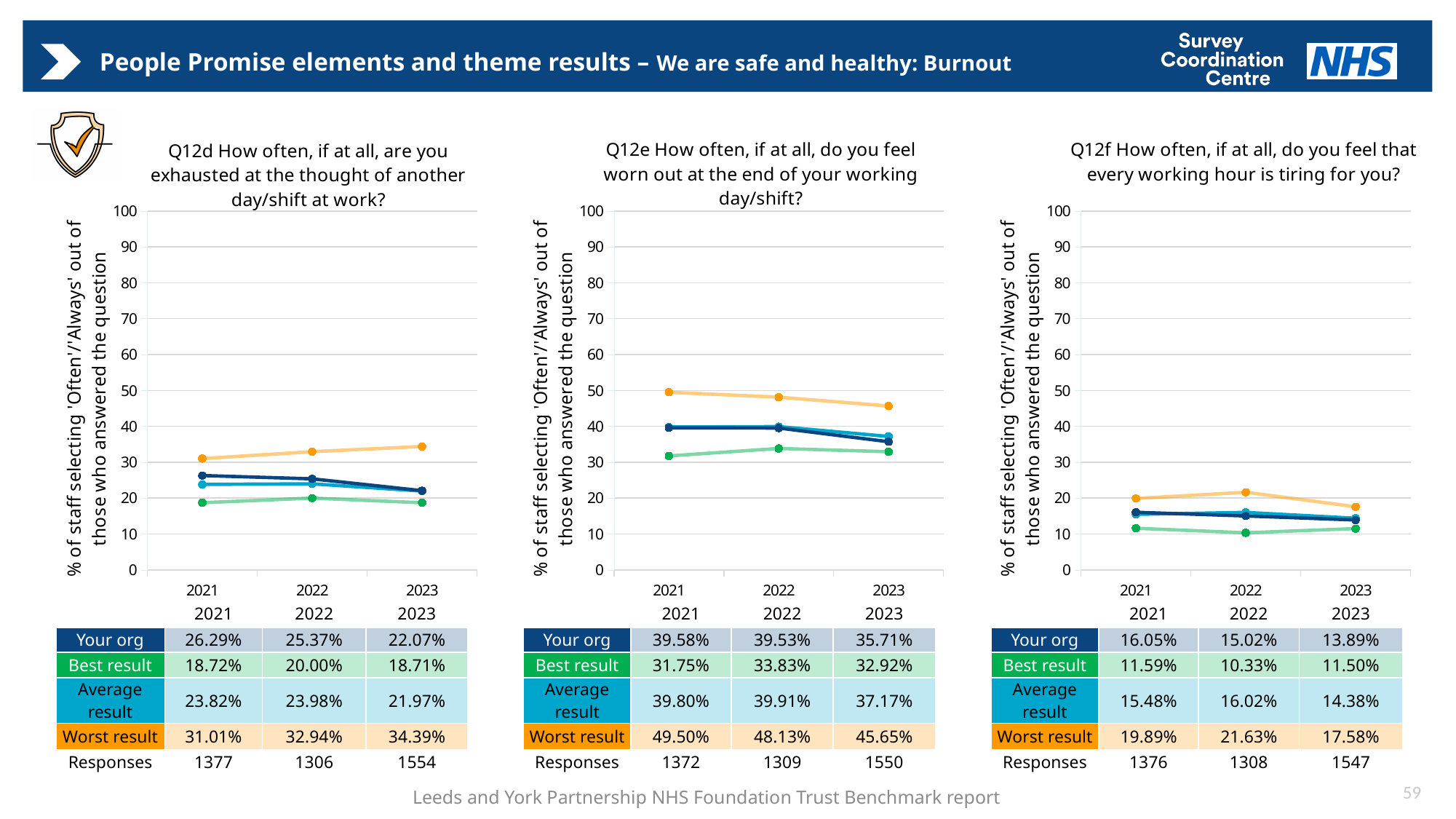
In the Q12f chart (right), what is the 'Average result' value for 2022? 16.02% In the Q12e chart (middle), is the 'Worst result' value for 2023 greater or less than 40? greater In the Q12f chart (right), does the 'Your org' line rise or fall from 2021 to 2023? fall In the Q12d chart (left), which is larger in 2021: the 'Your org' value or the 'Average result' value? Your org How many years are plotted on the x axis of the Q12d chart (left)? 3 In the Q12f chart (right), in which year is the 'Best result' value lowest? 2022 What kind of chart is used for Q12e (middle)? line chart In the Q12e chart (middle), what is the difference between the 'Your org' value and the 'Best result' value in 2023? 2.79% How many responses are recorded for the Q12f chart (right) in 2023? 1547 In the Q12d chart (left), in which year is the 'Worst result' line highest? 2023 In the Q12d chart (left), what is the 'Your org' value for 2023? 22.07% In the Q12e chart (middle), what is the 'Worst result' value for 2021? 49.50%